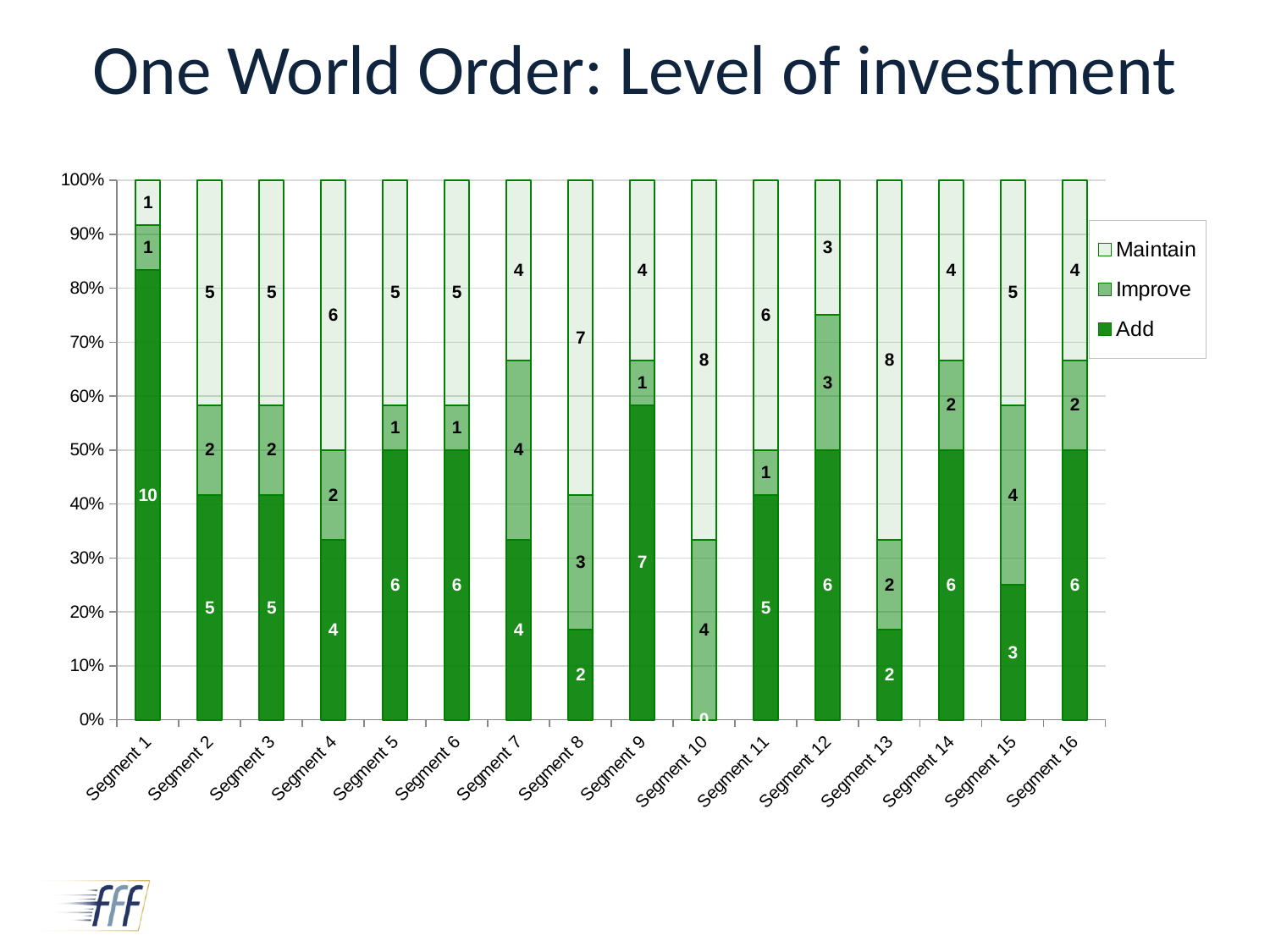
What is the Improve value for Segment 15? 4 What is the Add value for Segment 1? 10 What is the Maintain value for Segment 10? 8 How many series does the legend list? 3 Which is larger, the Add value for Segment 9 or the Add value for Segment 13? Segment 9 Which segment has the lowest Add value? Segment 10 How many segments are shown on the x axis? 16 What is the total of the three values in the Segment 7 bar? 12 What is the difference between the Maintain value for Segment 8 and the Maintain value for Segment 12? 4 What kind of chart is shown on the slide? Stacked bar chart Which segment has the highest Add value? Segment 1 Is the Add share of the Segment 1 bar greater or less than 80%? greater